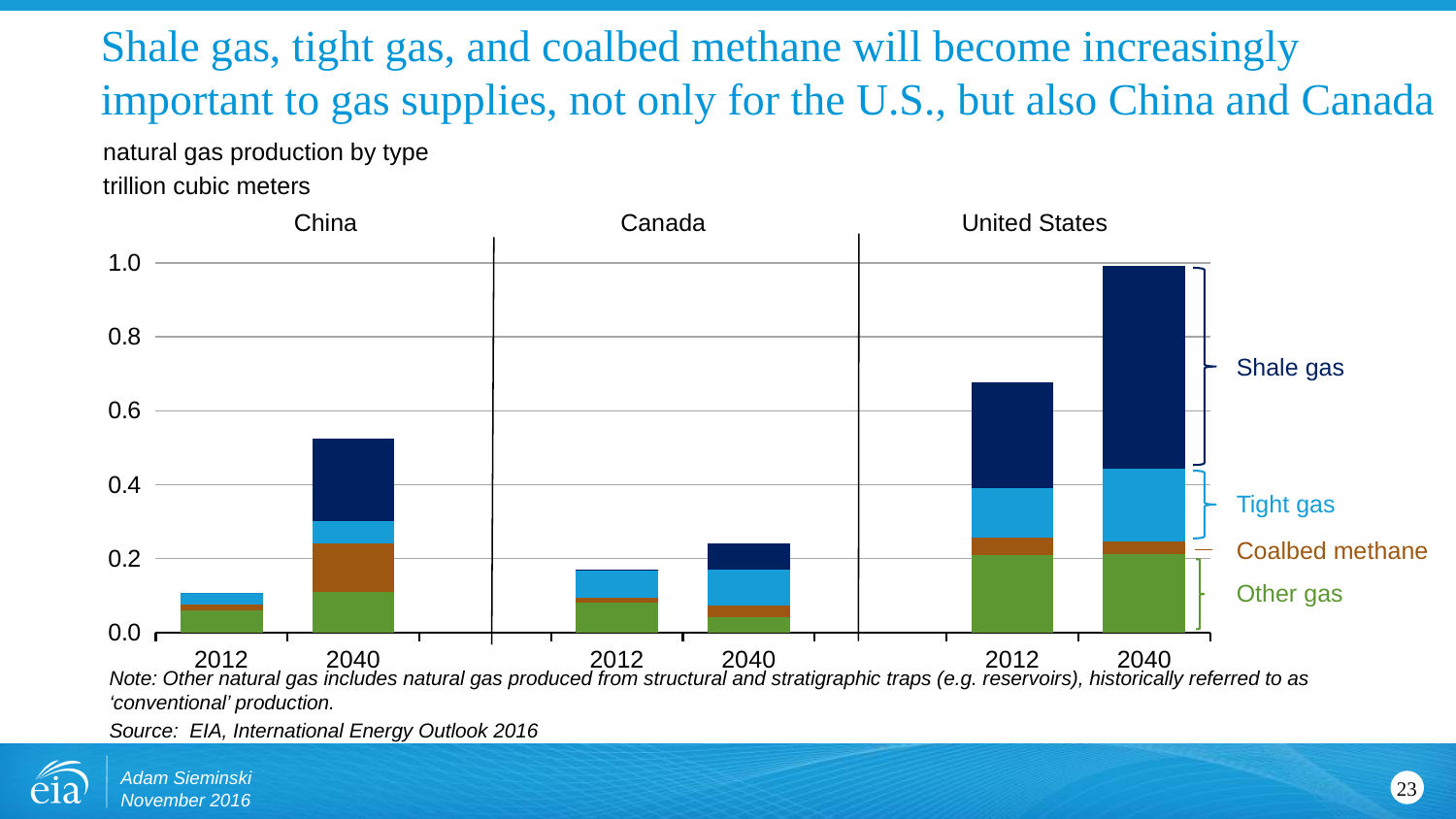
Which country and year has the highest total natural gas production in the chart? United States 2040 How many gas types (series) are labelled in the chart? 4 Does total natural gas production rise or fall from 2012 to 2040 for each of the three countries? Rise Is the total value for United States 2040 greater or less than 0.8? greater How many bars are plotted in the chart? 6 Is the total value for China 2040 greater or less than 0.4? greater Is the total value for United States 2012 greater or less than 0.6? greater Which country and year has the lowest total natural gas production in the chart? China 2012 What unit is natural gas production measured in on the chart? trillion cubic meters What kind of chart is shown on the slide? Stacked bar chart Which is larger in 2012, the total production for Canada or for China? Canada